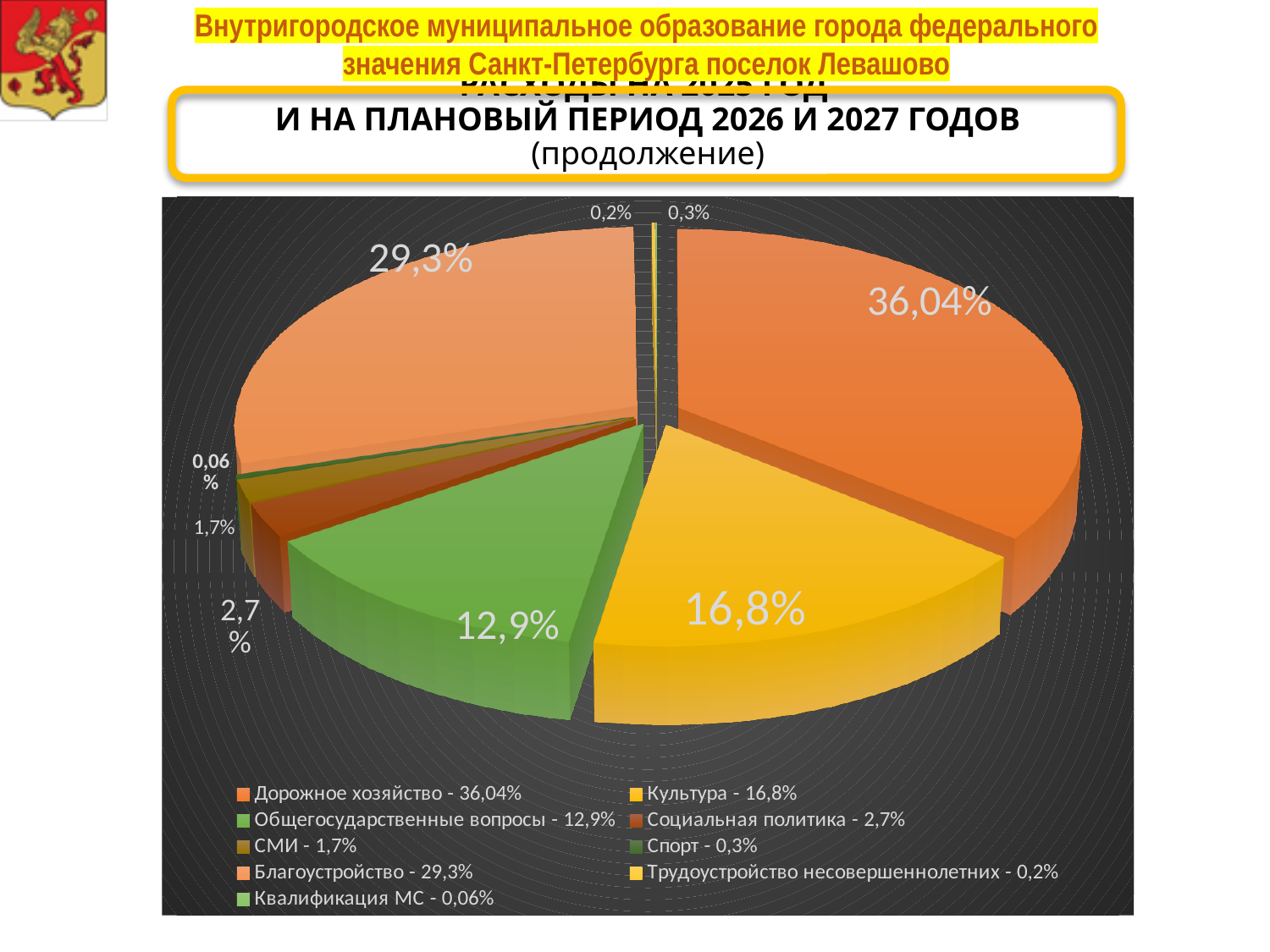
How many categories does the legend list? 9 Which is larger, the slice for Культура or the slice for Общегосударственные вопросы? Культура Which category has the smallest slice of the pie? Квалификация МС What is the value shown for СМИ? 1,7% What is the difference between the values for Дорожное хозяйство and Благоустройство? 6,74% What kind of chart is shown on the slide? pie chart What is the value shown for Культура? 16,8% What is the value shown for Благоустройство? 29,3% What share of the pie does Дорожное хозяйство have? 36,04% Which category has the largest slice of the pie? Дорожное хозяйство What is the value shown for Трудоустройство несовершеннолетних? 0,2% What is the value shown for Общегосударственные вопросы? 12,9%